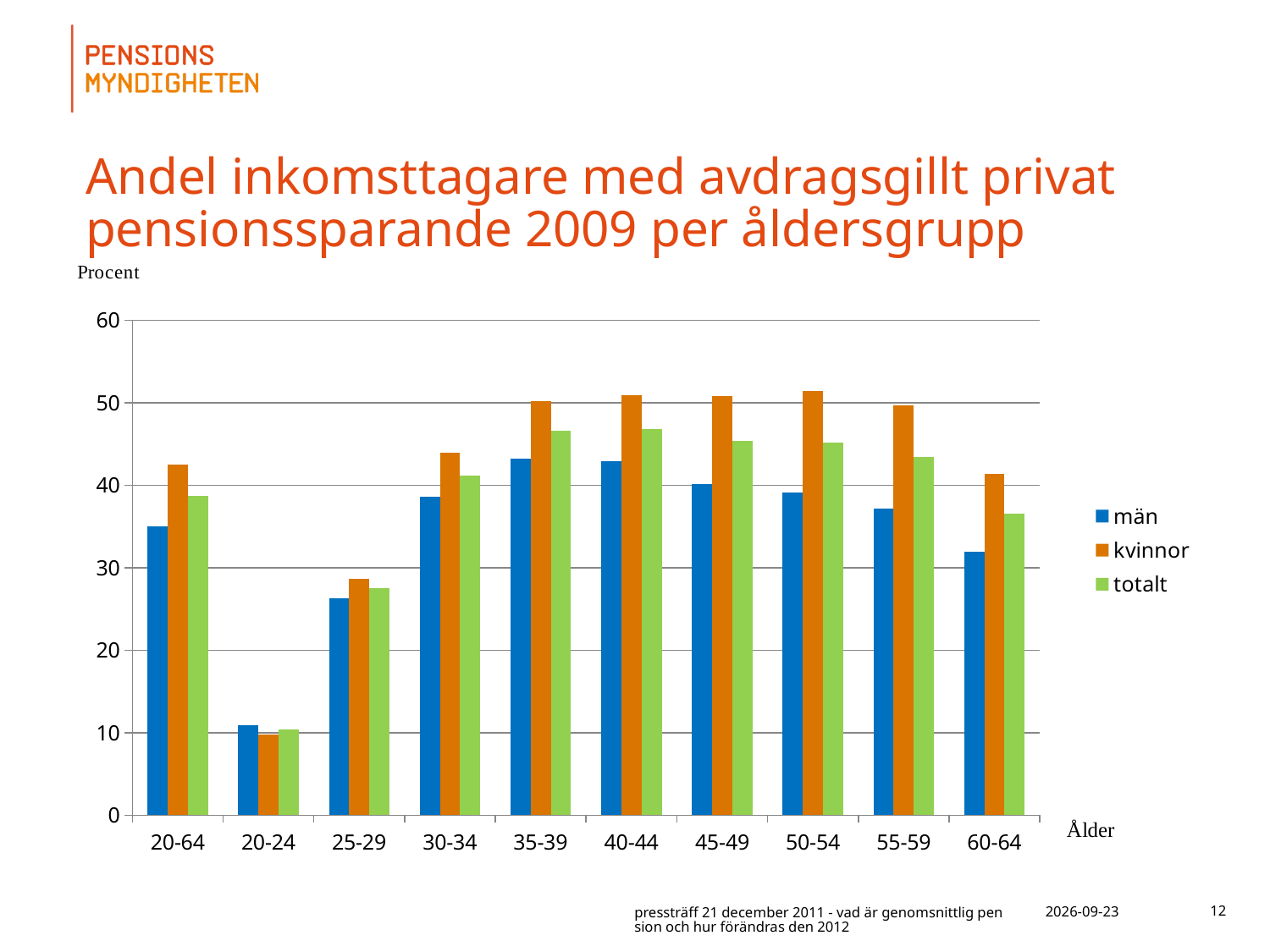
How many age groups are shown on the x axis? 10 Is the value for totalt in the 25-29 age group greater or less than 30? less In the 60-64 age group, which is larger: män or kvinnor? kvinnor Which age group has the lowest value for kvinnor? 20-24 Is the value for kvinnor in the 50-54 age group greater or less than 50? greater Is the value for totalt in the 60-64 age group greater or less than 40? less What kind of chart is shown on the slide? bar chart What label is shown on the x axis of the chart? Ålder Do the values for män rise or fall from the 40-44 age group to the 60-64 age group? fall Which age group has the lowest value for män? 20-24 How many series does the legend list? 3